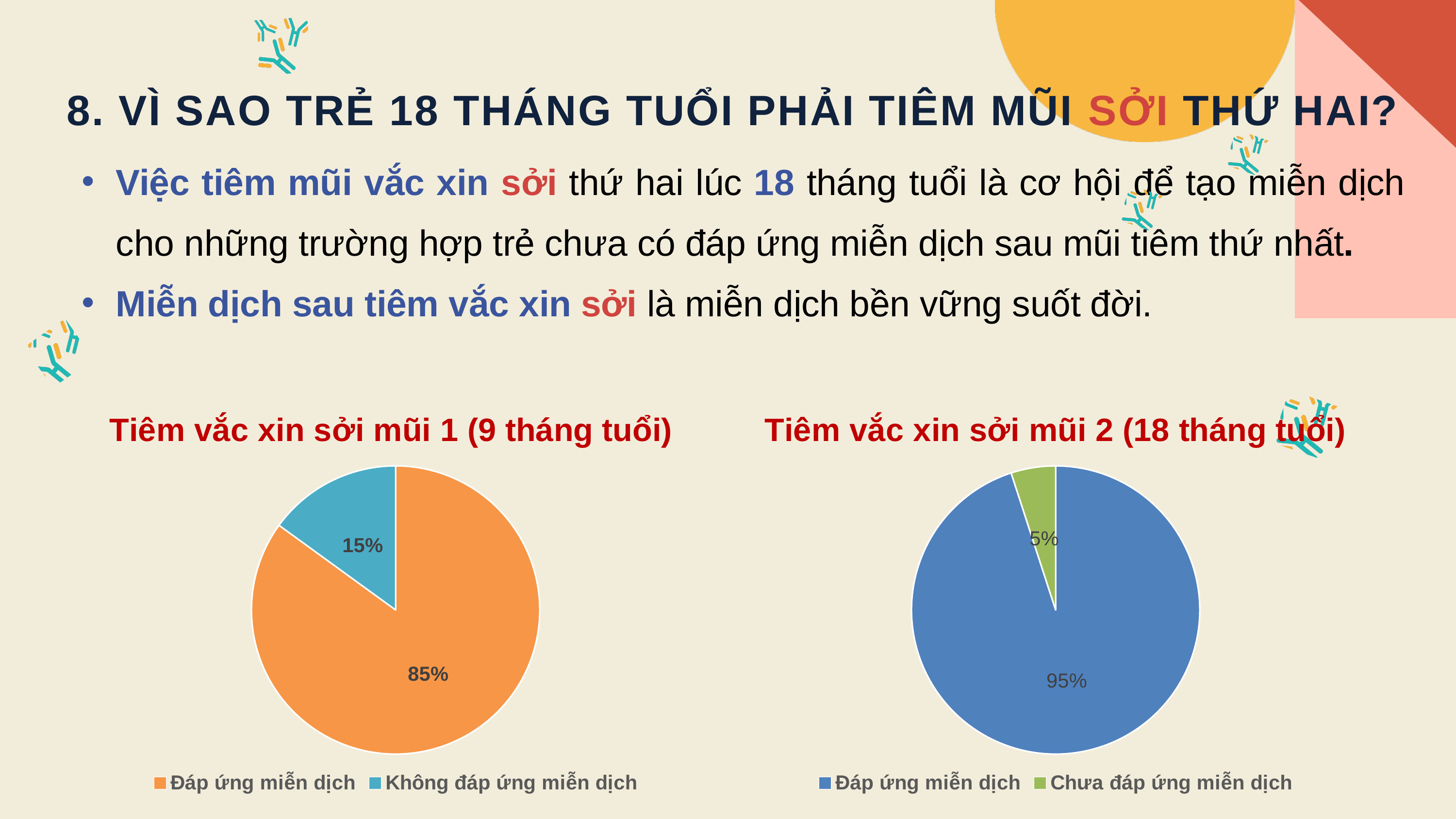
In the chart titled "Tiêm vắc xin sởi mũi 2 (18 tháng tuổi)", how many slices does the pie have? 2 In the chart titled "Tiêm vắc xin sởi mũi 1 (9 tháng tuổi)", what is the difference between the "Đáp ứng miễn dịch" and "Không đáp ứng miễn dịch" shares? 70% In the chart titled "Tiêm vắc xin sởi mũi 1 (9 tháng tuổi)", which slice is the largest? Đáp ứng miễn dịch In the chart titled "Tiêm vắc xin sởi mũi 2 (18 tháng tuổi)", what colour is the "Chưa đáp ứng miễn dịch" slice? Green In the chart titled "Tiêm vắc xin sởi mũi 2 (18 tháng tuổi)", which slice is the smallest? Chưa đáp ứng miễn dịch In the chart titled "Tiêm vắc xin sởi mũi 1 (9 tháng tuổi)", what share is labelled for "Đáp ứng miễn dịch"? 85% In the chart titled "Tiêm vắc xin sởi mũi 1 (9 tháng tuổi)", what share is labelled for "Không đáp ứng miễn dịch"? 15% In the chart titled "Tiêm vắc xin sởi mũi 2 (18 tháng tuổi)", what share is labelled for "Đáp ứng miễn dịch"? 95% In the chart titled "Tiêm vắc xin sởi mũi 1 (9 tháng tuổi)", how many entries does the legend list? 2 What kind of chart is the left chart, "Tiêm vắc xin sởi mũi 1 (9 tháng tuổi)"? Pie chart What kind of chart is the right chart, "Tiêm vắc xin sởi mũi 2 (18 tháng tuổi)"? Pie chart In the chart titled "Tiêm vắc xin sởi mũi 2 (18 tháng tuổi)", what share is labelled for "Chưa đáp ứng miễn dịch"? 5%